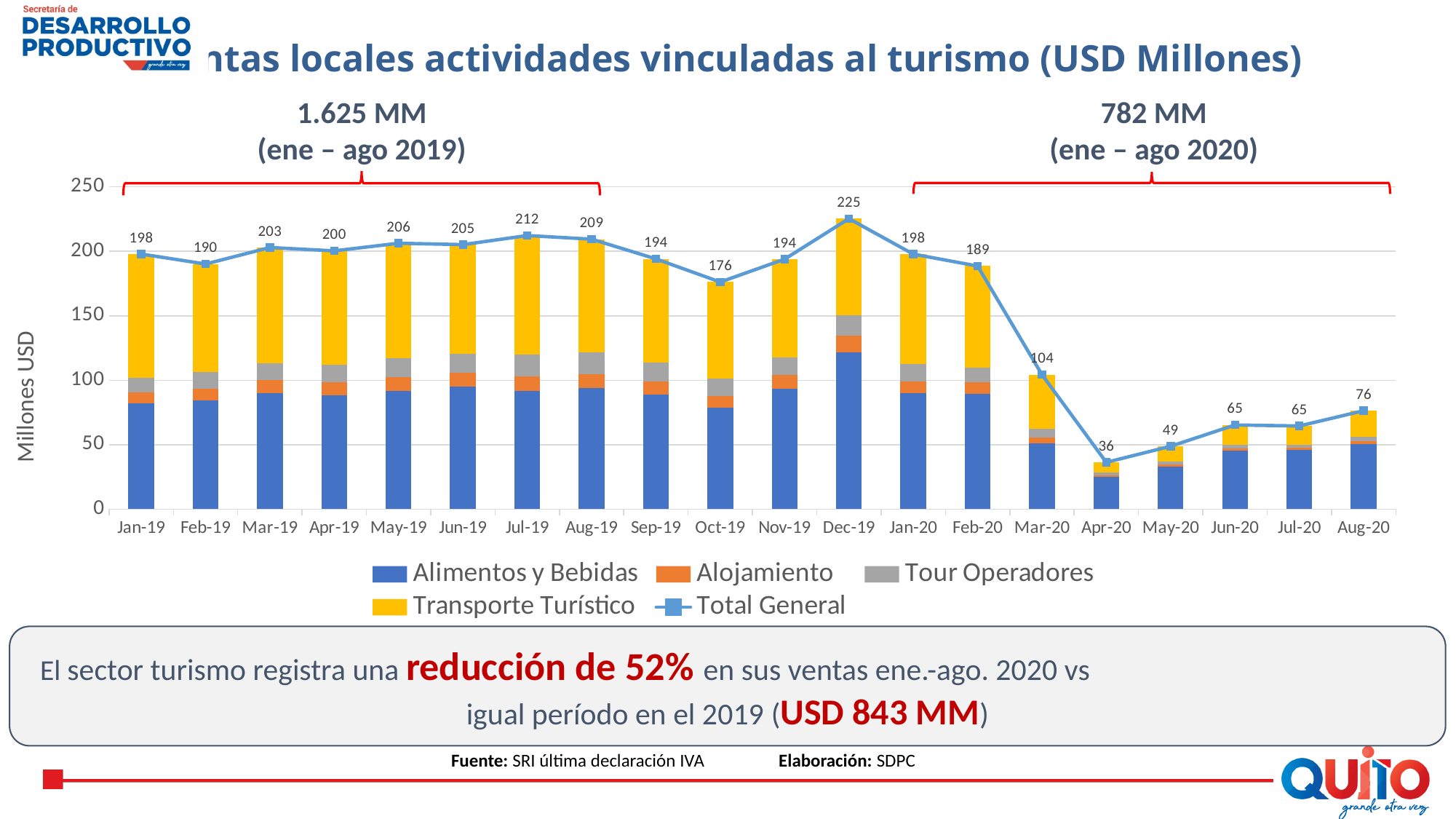
How many series does the legend list? 5 Does the Total General value rise or fall from Feb-20 to Apr-20? Fall Which month has the lowest Total General value? Apr-20 How many months are shown on the x axis? 20 Is the Alimentos y Bebidas value for Dec-19 greater or less than 100? greater What is the difference between the Total General values for Aug-19 and Aug-20? 133 Which is larger, the Total General value for Jul-19 or for Aug-19? Jul-19 What is the Total General value for Apr-20? 36 What kind of chart is shown on the slide? A stacked bar chart with a line Which month has the highest Total General value? Dec-19 What is the Total General value for Dec-19? 225 Which colour represents Transporte Turístico in the legend? Yellow